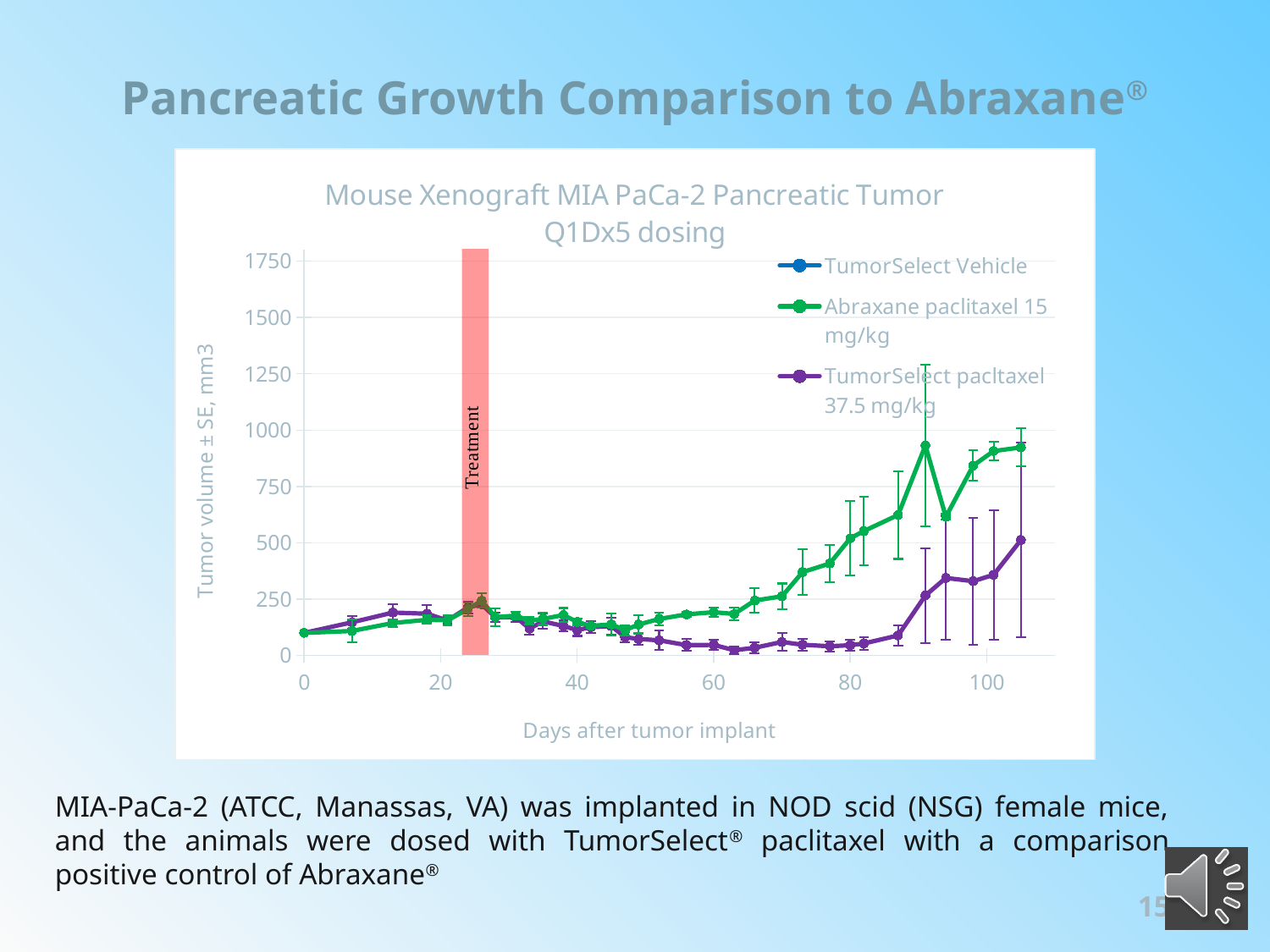
At the last time point (around day 105), which series has the larger tumor volume: Abraxane paclitaxel 15 mg/kg or TumorSelect pacltaxel 37.5 mg/kg? Abraxane paclitaxel 15 mg/kg Is the value for TumorSelect pacltaxel 37.5 mg/kg around day 60 greater or less than 250? less What is the label of the x axis of the chart? Days after tumor implant Is the value for TumorSelect pacltaxel 37.5 mg/kg at the last time point (around day 105) greater or less than 750? less Does the Abraxane paclitaxel 15 mg/kg series generally rise or fall between day 40 and day 105? rise What is the title of the chart? Mouse Xenograft MIA PaCa-2 Pancreatic Tumor Q1Dx5 dosing Which series reaches the highest tumor volume on the chart? Abraxane paclitaxel 15 mg/kg Does the TumorSelect pacltaxel 37.5 mg/kg series rise or fall between about day 27 and day 60? fall How many series does the chart legend list? 3 What kind of chart is shown on the slide? Line chart Is the value for TumorSelect pacltaxel 37.5 mg/kg at the last time point (around day 105) greater or less than 250? greater